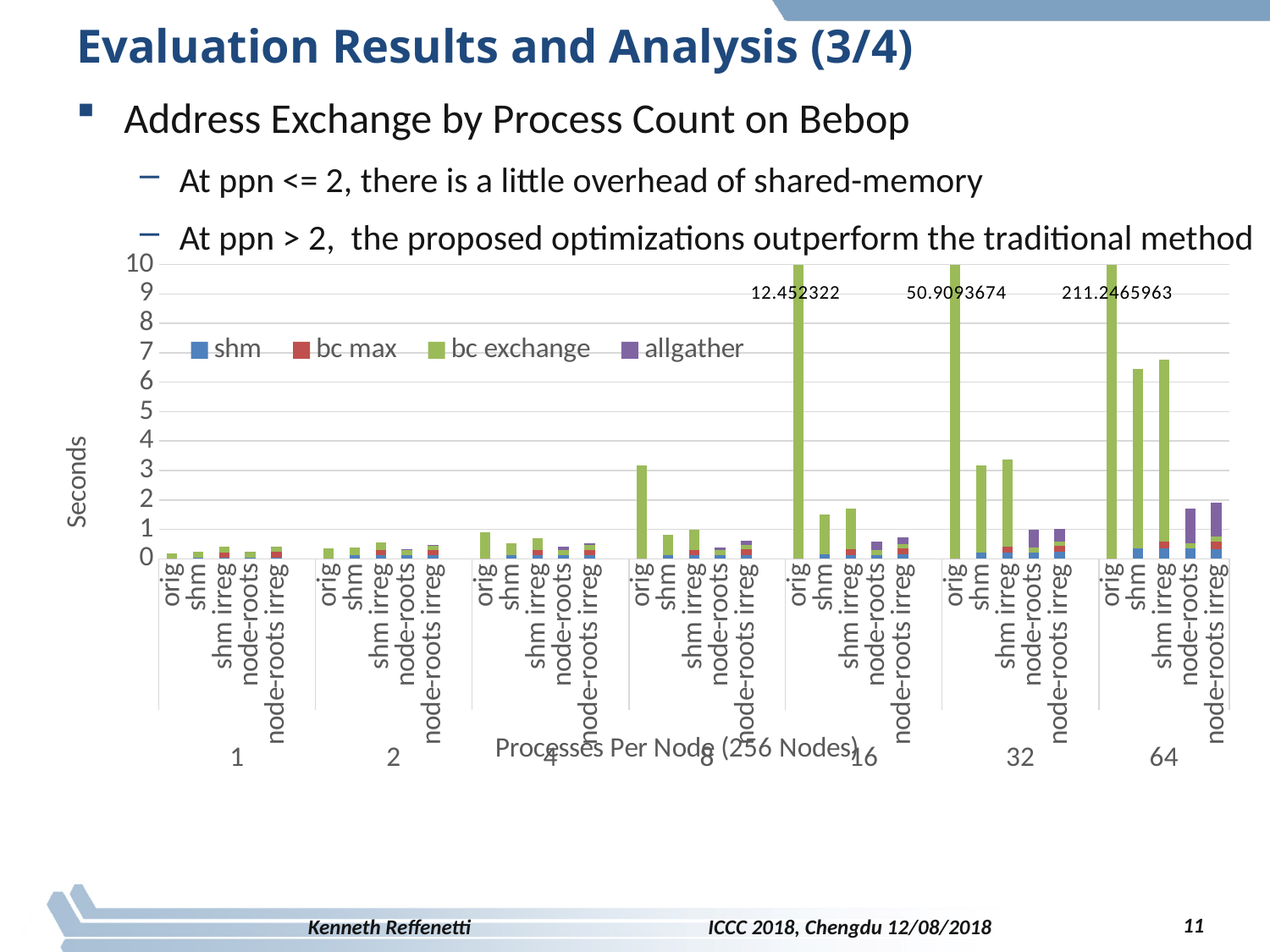
Is the value for the orig bar at 8 processes per node greater or less than 2? greater At 64 processes per node, which bar is taller: shm irreg or node-roots? shm irreg What kind of chart is shown on the slide? bar chart What is the difference between the labelled orig values at 64 and 32 processes per node? 160.3372289 What is the title of the y axis? Seconds What value is labelled on the orig bar at 32 processes per node? 50.9093674 What value is labelled on the orig bar at 16 processes per node? 12.452322 What value is labelled on the orig bar at 64 processes per node? 211.2465963 Is the value for the shm bar at 64 processes per node greater or less than 5? greater How many series does the chart legend list? 4 Which processes-per-node group has the tallest orig bar? 64 How many processes-per-node groups are shown on the x axis? 7